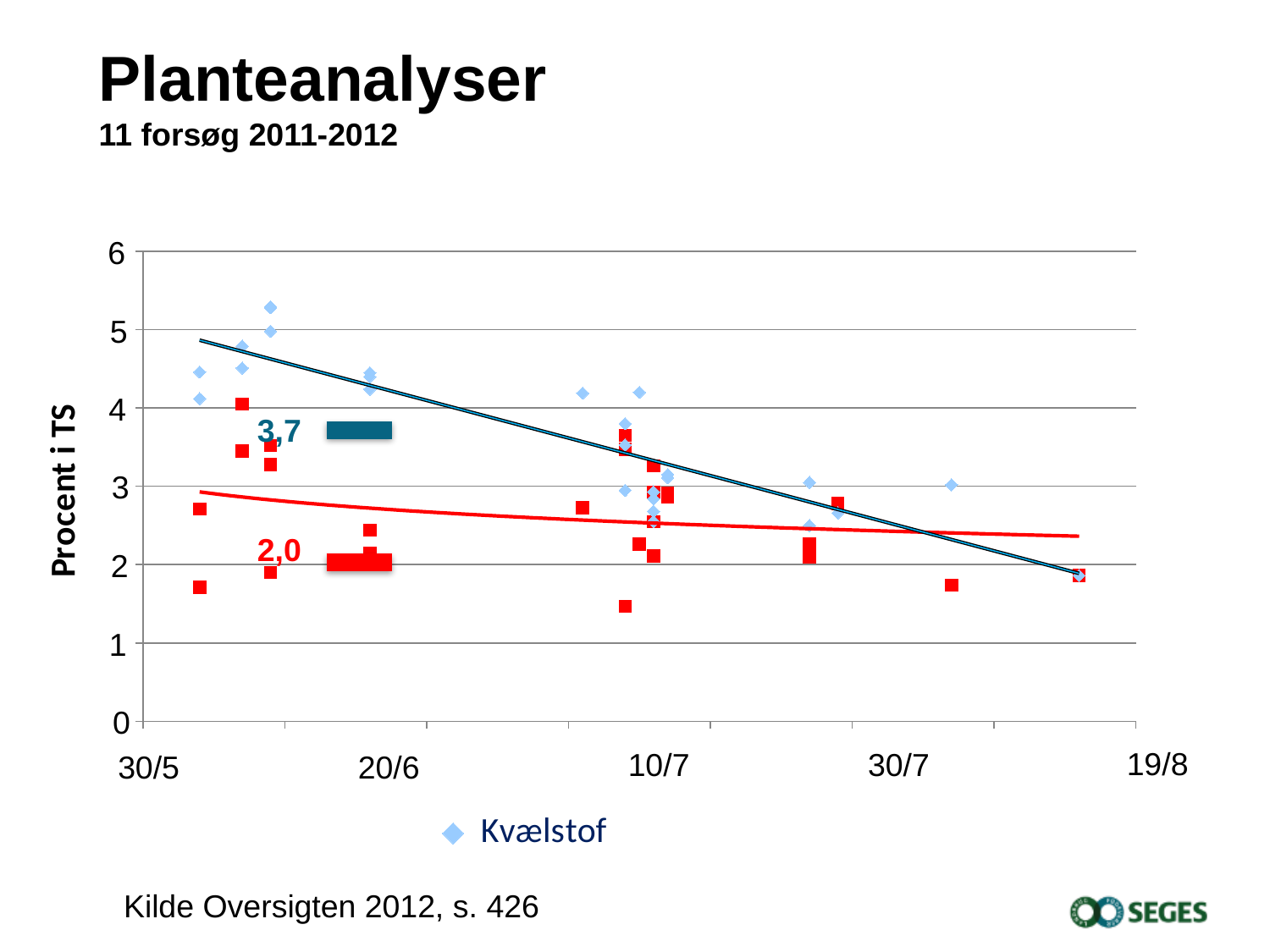
Does the Kvælstof trend line rise or fall from 30/5 to 19/8? Fall What value is printed next to the red reference bar on the chart? 2,0 Which series is named in the chart's legend? Kvælstof What is the title of the slide containing the chart? Planteanalyser What is the maximum value shown on the vertical axis of the chart? 6 What kind of chart is shown on the slide? Scatter chart Is the Kvælstof trend line at 30/5 greater or less than 4? greater What value is printed next to the dark blue reference bar on the chart? 3,7 How many series does the chart's legend list? 1 Is the Kvælstof trend line at its right-hand end (near 19/8) greater or less than 3? less Is the highest Kvælstof point on the chart greater or less than 5? greater